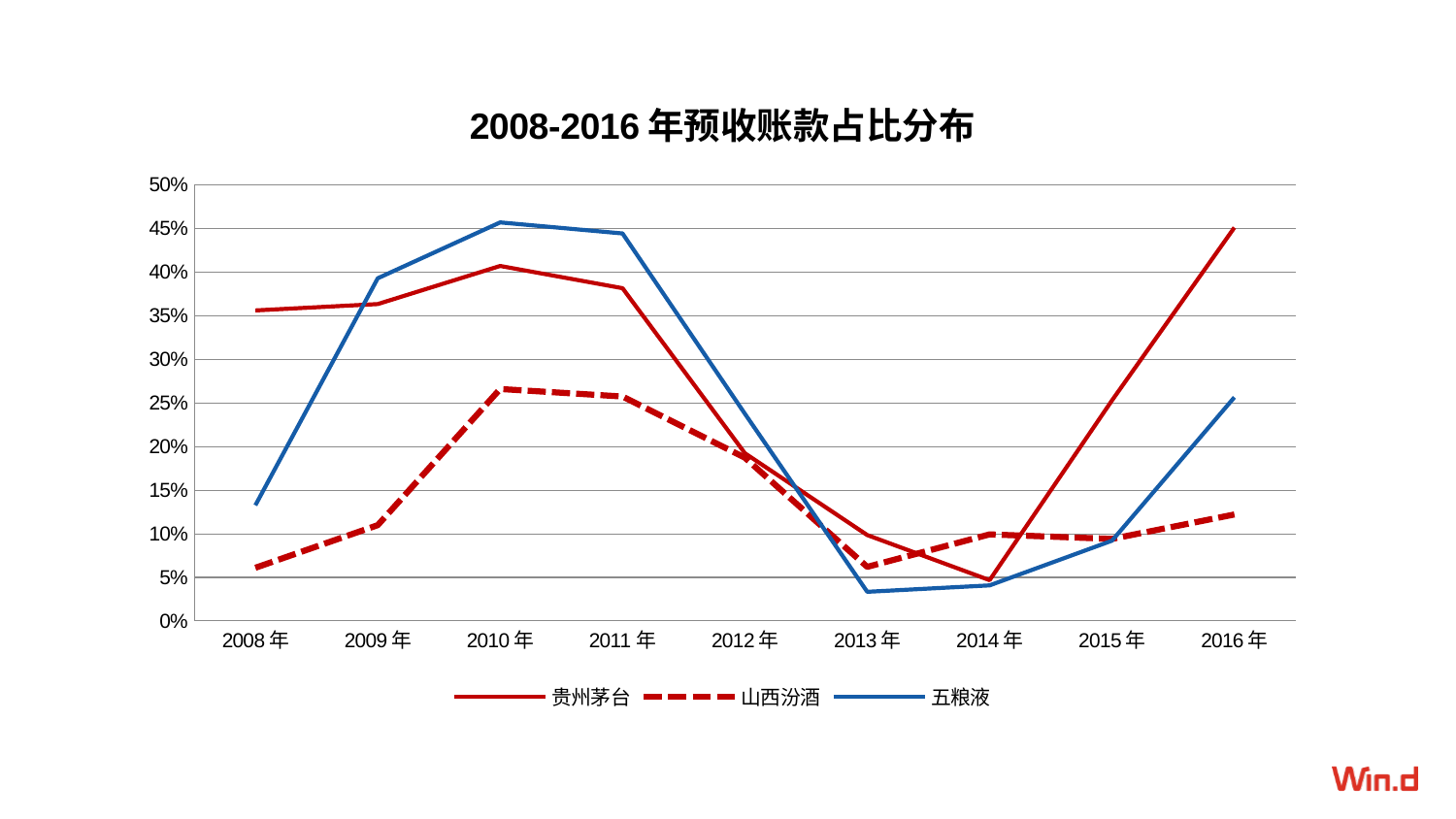
How many years are plotted along the x axis? 9 Does the value for 五粮液 rise or fall from 2011年 to 2013年? fall Is the value for 山西汾酒 in 2008年 greater or less than 10%? less In which year does 贵州茅台 reach its highest value? 2016年 In 2016年, which is larger: 贵州茅台 or 五粮液? 贵州茅台 How many series does the legend list? 3 What kind of chart is shown on the slide? line chart Which series is drawn with a dashed line? 山西汾酒 In which year does 贵州茅台 reach its lowest value? 2014年 Is the value for 五粮液 in 2010年 greater or less than 40%? greater Is the value for 贵州茅台 in 2014年 greater or less than 10%? less In which year does 五粮液 reach its highest value? 2010年